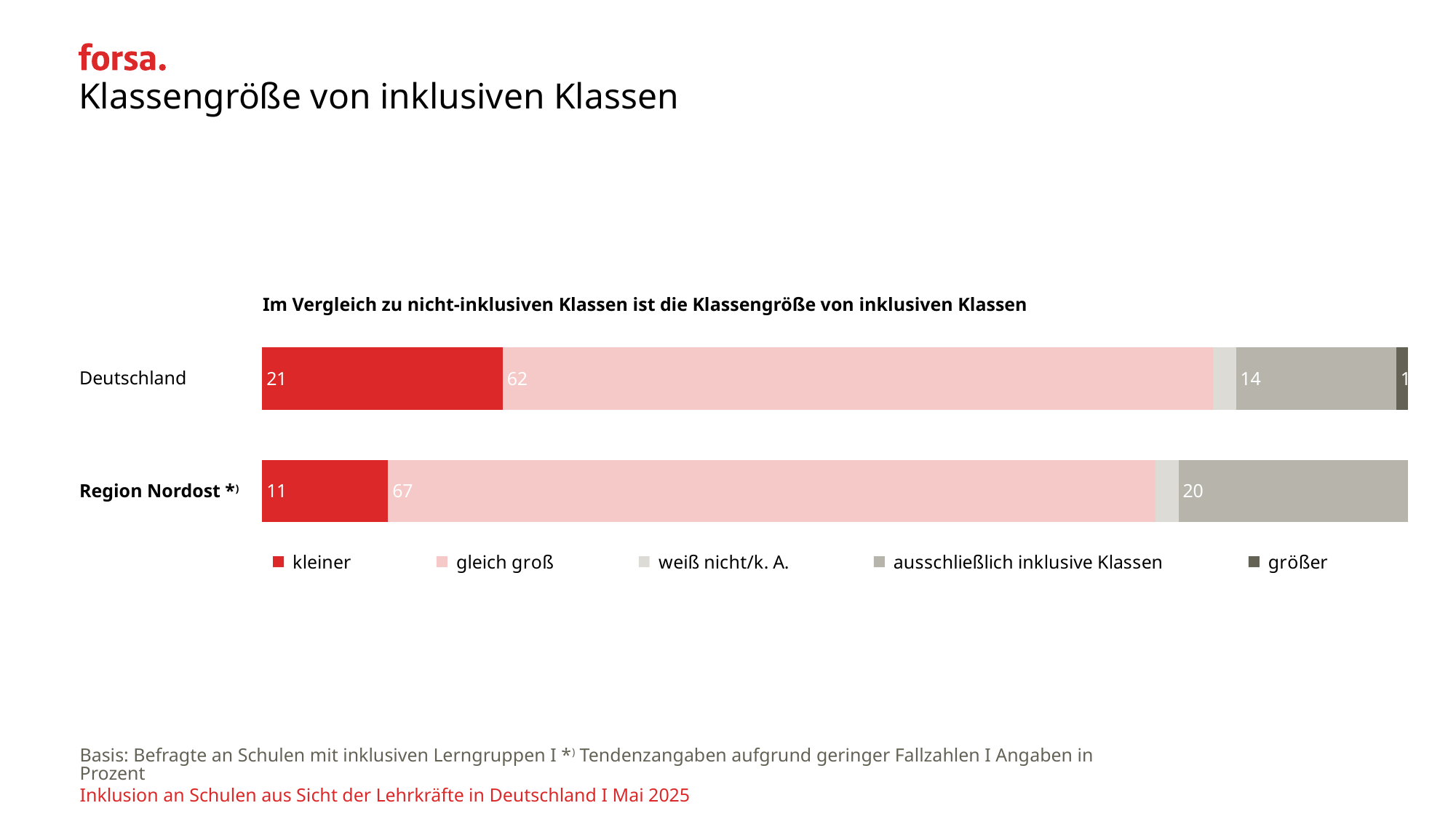
What is the difference between the "gleich groß" values for Region Nordost and Deutschland? 5 By how much does the "kleiner" value for Deutschland exceed that for Region Nordost? 10 What is the value for "gleich groß" in Region Nordost? 67 What percentage of respondents in Deutschland say inclusive classes are "kleiner"? 21 What kind of chart is shown on the slide? Stacked bar chart What is the value for "kleiner" in Region Nordost? 11 How many regions (bars) are shown in the chart? 2 Which region has the larger value for "ausschließlich inklusive Klassen"? Region Nordost Which region has the larger value for "kleiner", Deutschland or Region Nordost? Deutschland What is the value for "ausschließlich inklusive Klassen" for Deutschland? 14 How many series does the legend list? 5 What is the value for "größer" for Deutschland? 1